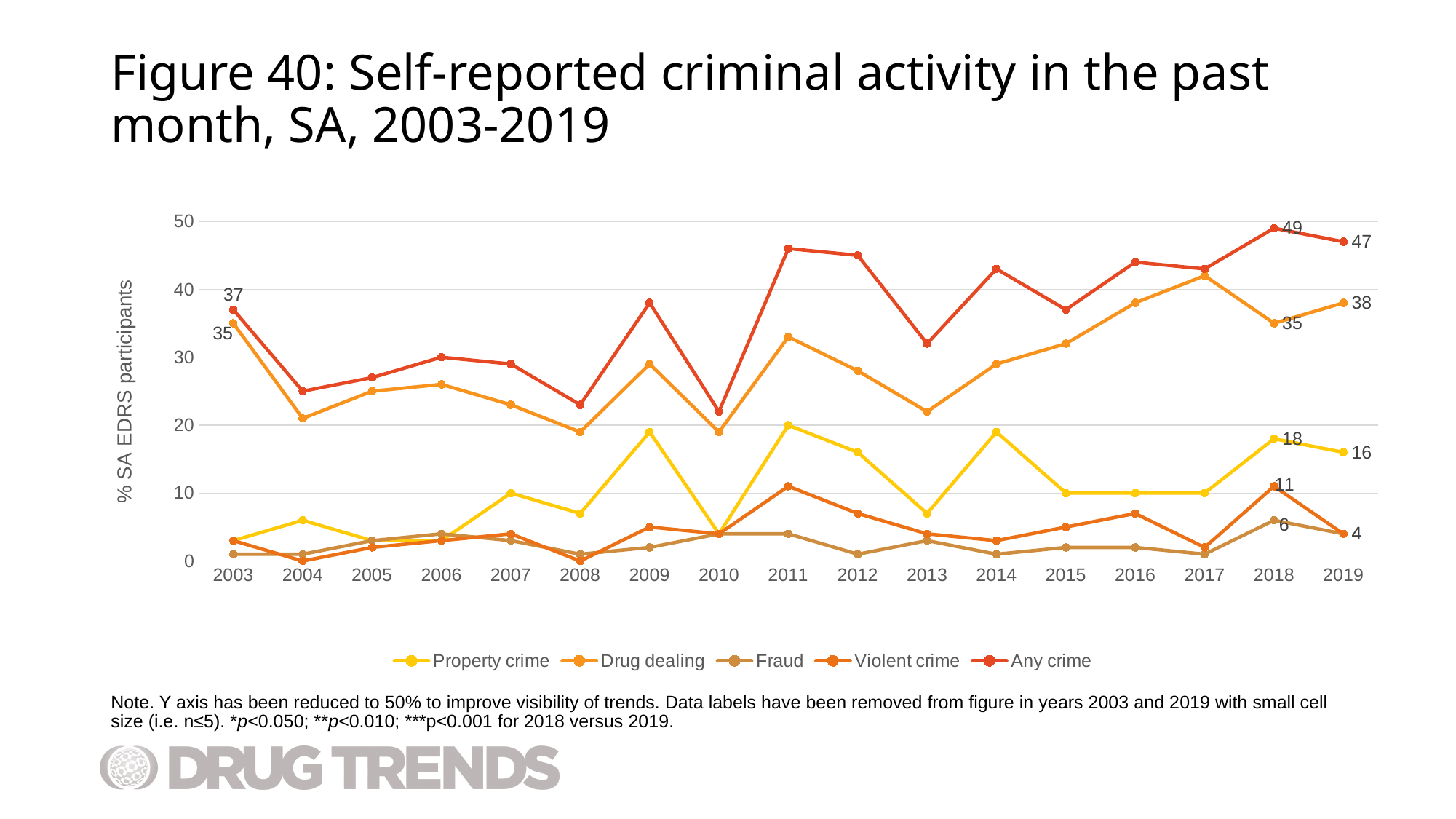
By how much did Drug dealing change from 2018 to 2019? 3 What kind of chart is shown on the slide? Line chart What is the value for Any crime in 2019? 47 What is the value for Property crime in 2018? 18 What is the value for Any crime in 2018? 49 What is the difference between the Any crime values in 2018 and 2019? 2 Is the value for Any crime in 2011 greater or less than 40? greater In which year is the Any crime series at its highest? 2018 How many series does the legend list? 5 Which is larger, the Any crime value in 2003 or in 2019? 2019 What is the value for Drug dealing in 2019? 38 How many years are plotted along the x axis? 17